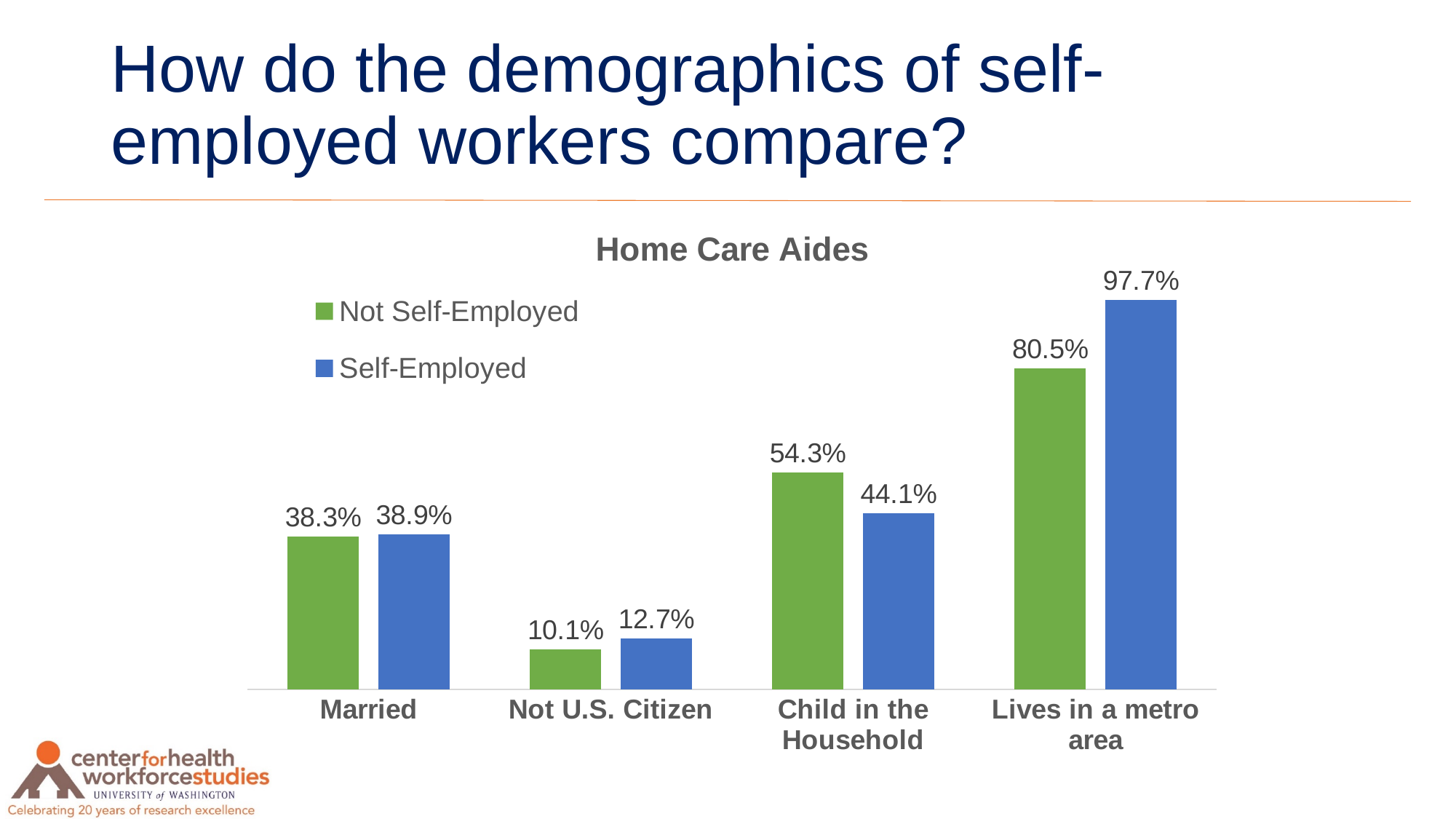
How many categories are shown on the x axis? 4 Which category has the highest value for Not Self-Employed? Lives in a metro area What type of chart is shown on the slide? Bar chart What is the difference between the Self-Employed and Not Self-Employed values in the Lives in a metro area category? 17.2% What is the value for Not Self-Employed in the Child in the Household category? 54.3% What is the value for Self-Employed in the Lives in a metro area category? 97.7% What is the value for Self-Employed in the Married category? 38.9% What is the value for Not Self-Employed in the Not U.S. Citizen category? 10.1% Which category has the lowest value for Self-Employed? Not U.S. Citizen What is the difference between the Not Self-Employed and Self-Employed values in the Child in the Household category? 10.2% In the Child in the Household category, which is larger: Not Self-Employed or Self-Employed? Not Self-Employed How many series does the legend list? 2